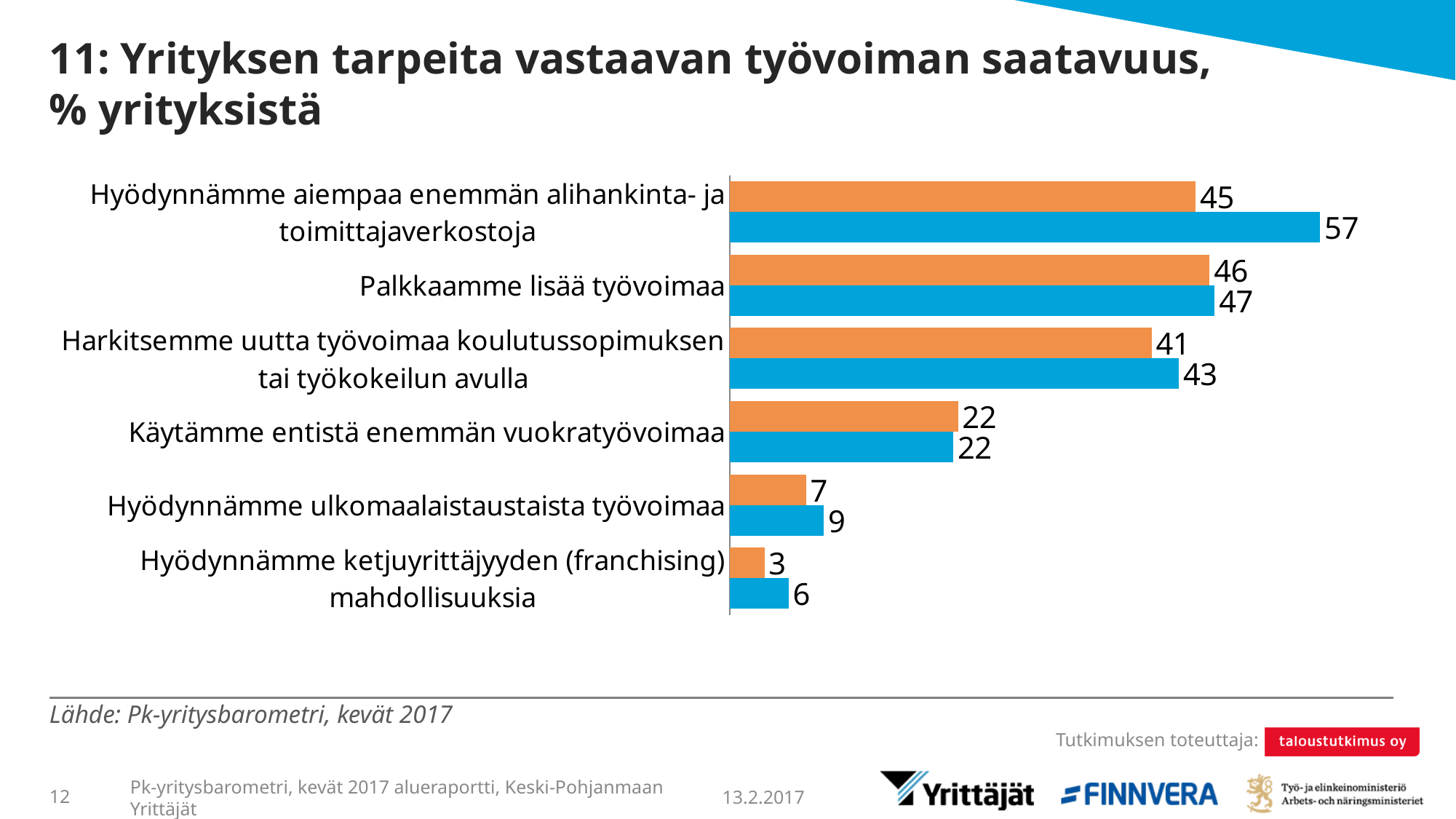
What is the value of the blue bar for "Hyödynnämme aiempaa enemmän alihankinta- ja toimittajaverkostoja"? 57 What is the difference between the blue and orange bar values for "Hyödynnämme aiempaa enemmän alihankinta- ja toimittajaverkostoja"? 12 Which category has the highest blue bar value? Hyödynnämme aiempaa enemmän alihankinta- ja toimittajaverkostoja For "Käytämme entistä enemmän vuokratyövoimaa", is the orange bar value larger than, smaller than, or equal to the blue bar value? equal What is the source cited below the chart? Pk-yritysbarometri, kevät 2017 What is the value of the orange bar for "Palkkaamme lisää työvoimaa"? 46 What is the difference between the blue and orange bar values for "Hyödynnämme ketjuyrittäjyyden (franchising) mahdollisuuksia"? 3 How many categories are shown on the chart? 6 What kind of chart is shown on the slide? bar chart What is the value of the orange bar for "Harkitsemme uutta työvoimaa koulutussopimuksen tai työkokeilun avulla"? 41 Which category has the lowest orange bar value? Hyödynnämme ketjuyrittäjyyden (franchising) mahdollisuuksia What is the value of the blue bar for "Hyödynnämme ulkomaalaistaustaista työvoimaa"? 9